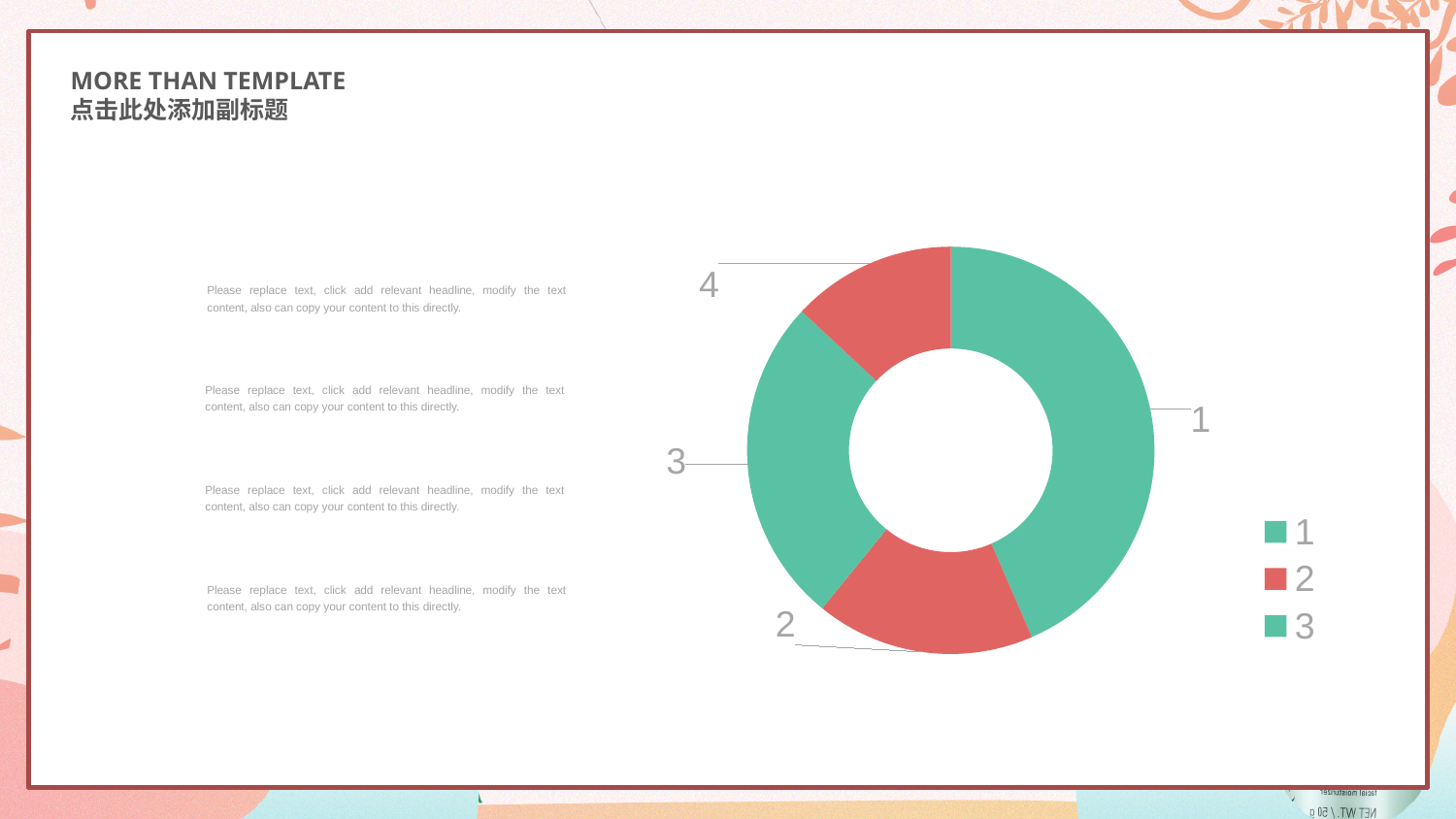
Which slice of the doughnut chart is the largest? 1 What colour is slice 2 in the doughnut chart? red Which slice of the doughnut chart is the smallest? 4 Which slice is larger in the doughnut chart, 3 or 4? 3 How many entries does the legend of the doughnut chart list? 3 Which slice is larger in the doughnut chart, 1 or 2? 1 What colour is slice 1 in the doughnut chart? green How many slices does the doughnut chart have? 4 Which slice is larger in the doughnut chart, 1 or 3? 1 What kind of chart is shown on the slide? doughnut chart